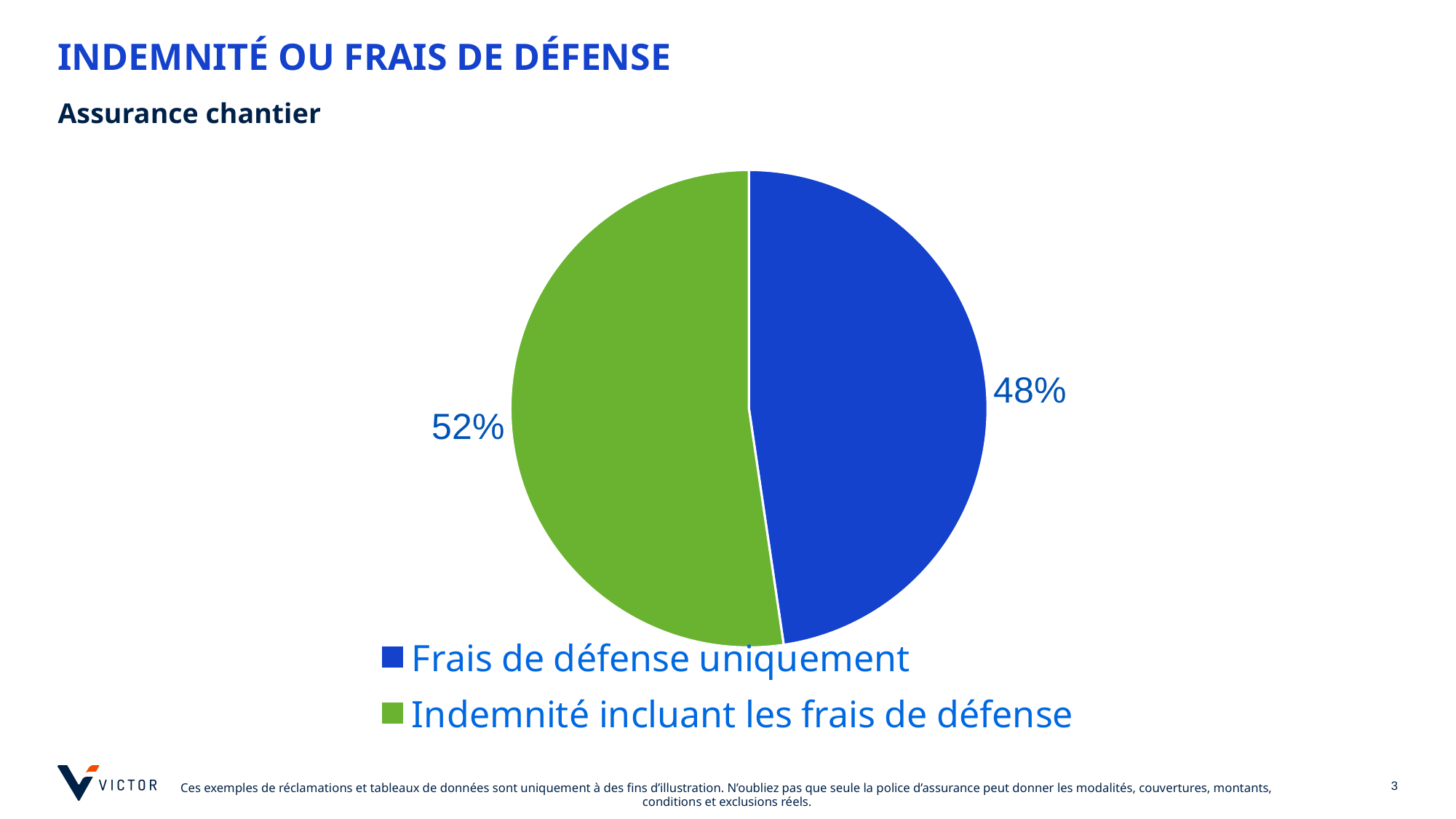
What is the title of the slide containing the chart? INDEMNITÉ OU FRAIS DE DÉFENSE What share of the pie is labelled "Frais de défense uniquement"? 48% What colour is the slice for "Indemnité incluant les frais de défense"? Green What share of the pie is labelled "Indemnité incluant les frais de défense"? 52% How many entries does the legend list? 2 What kind of chart is shown on the slide? Pie chart How many slices does the pie chart have? 2 Which slice of the pie is the largest? Indemnité incluant les frais de défense Which is larger: the share for "Frais de défense uniquement" or the share for "Indemnité incluant les frais de défense"? Indemnité incluant les frais de défense Is the share for "Frais de défense uniquement" greater or less than 50%? less What is the difference in percentage points between the "Indemnité incluant les frais de défense" slice and the "Frais de défense uniquement" slice? 4 percentage points Which slice of the pie is the smallest? Frais de défense uniquement